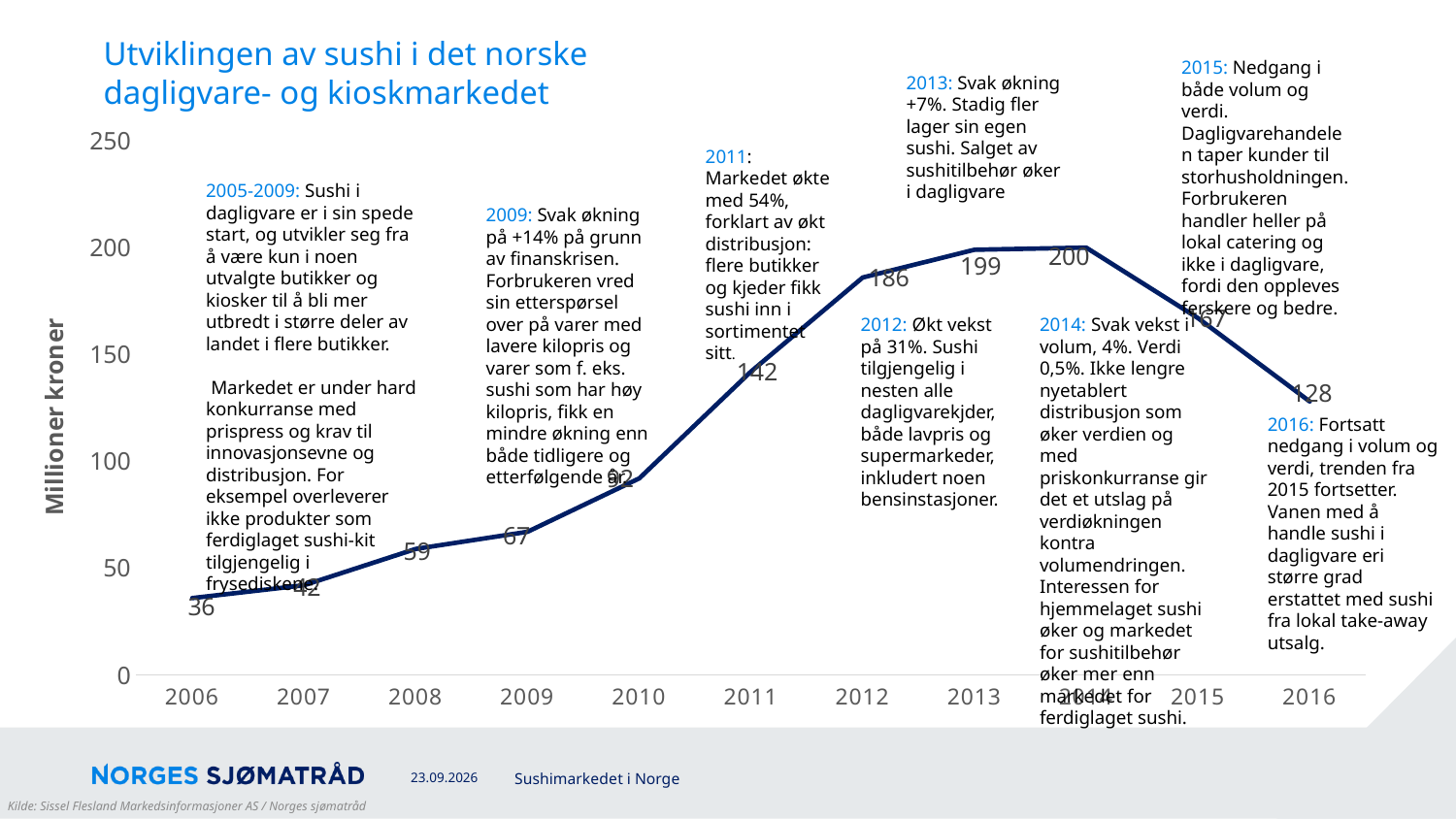
How many years are plotted on the x axis? 11 What is the difference between the values for 2011 and 2010? 50 Which year has the lowest value? 2006 Do the values rise or fall from 2006 to 2014? rise What is the difference between the values for 2014 and 2016? 72 Is the value for 2015 greater or less than 200? less Which is larger, the value for 2012 or the value for 2016? 2012 What is the value for 2006? 36 What is the value for 2010? 92 What kind of chart is shown on the slide? line chart What is the value for 2016? 128 What is the value for 2011? 142